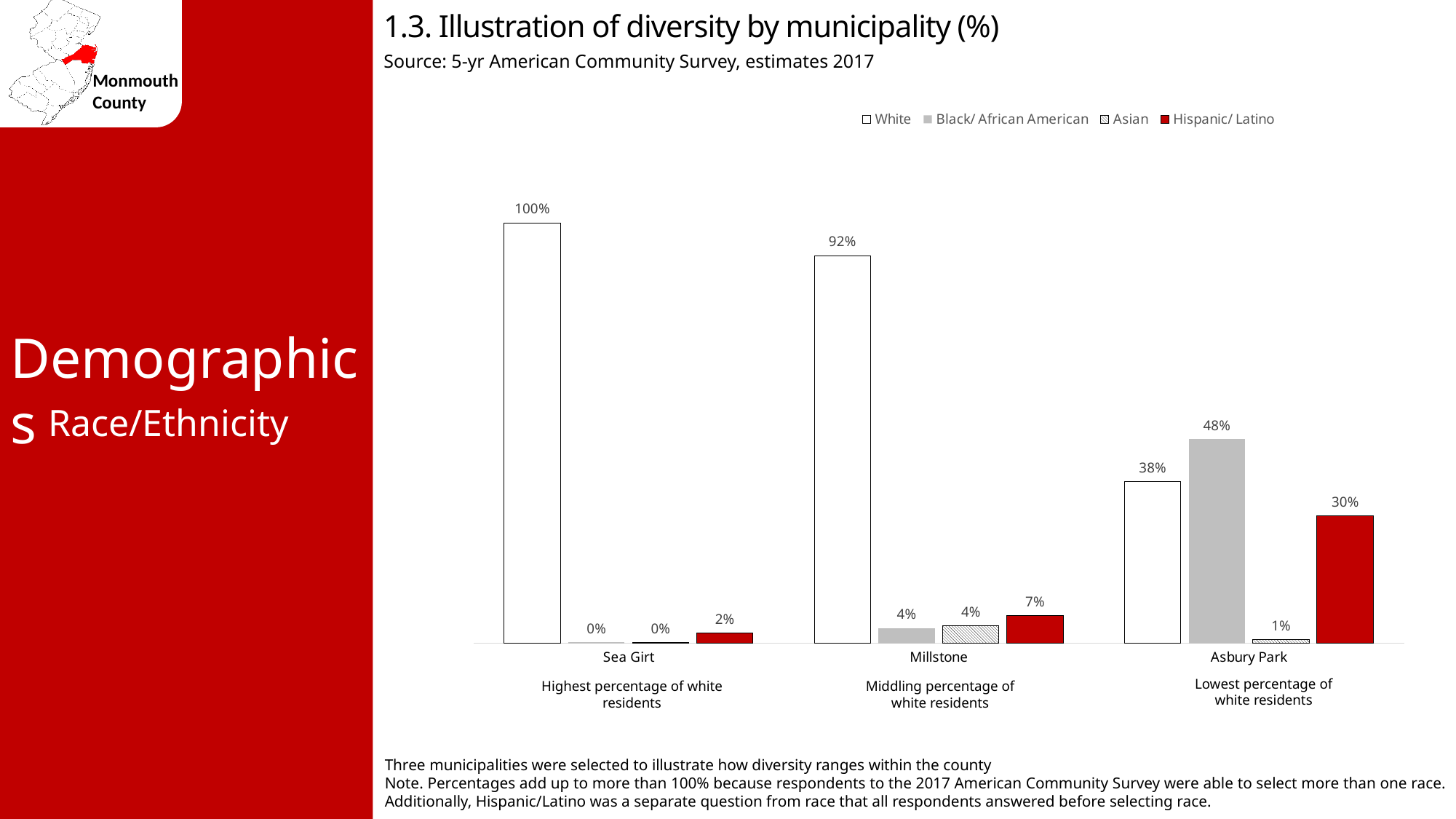
What kind of chart is shown on the slide? Bar chart Which municipality has the lowest White percentage? Asbury Park What is the White percentage for Sea Girt? 100% What is the source cited for the chart? 5-yr American Community Survey, estimates 2017 What is the Black/ African American percentage for Asbury Park? 48% What is the difference between the White percentage for Sea Girt and for Millstone? 8% Which is larger for Asbury Park: the Black/ African American percentage or the Hispanic/ Latino percentage? Black/ African American How many municipalities are shown on the x axis? 3 What is the Hispanic/ Latino percentage for Millstone? 7% What is the Asian percentage for Asbury Park? 1% Which municipality has the highest White percentage? Sea Girt How many series does the legend list? 4